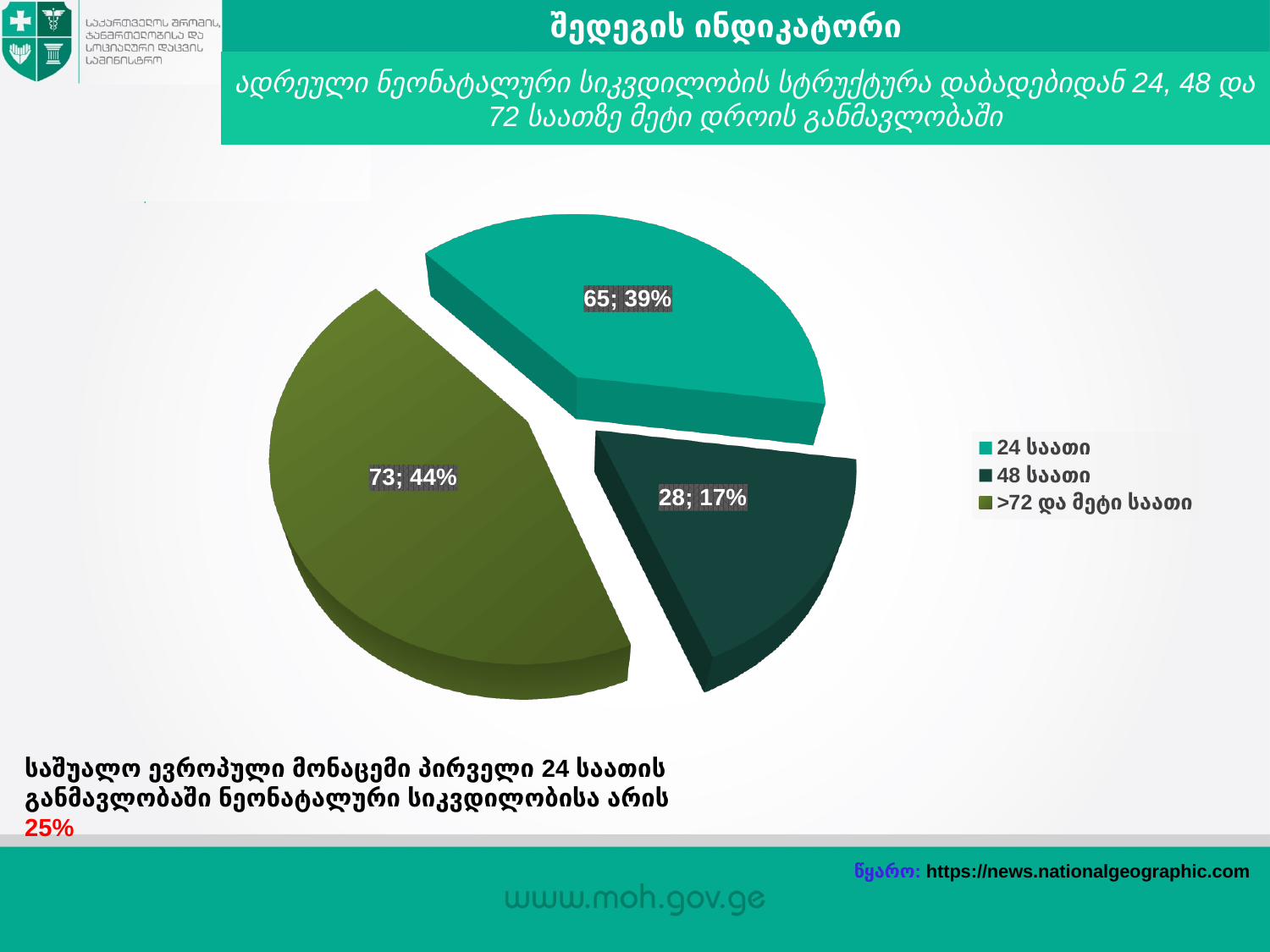
What kind of chart is shown on the slide? pie chart What percentage share does the ">72 და მეტი საათი" slice have? 44% What is the count shown for the ">72 და მეტი საათი" slice? 73 How many slices does the pie chart have? 3 What percentage share does the "48 საათი" slice have? 17% What percentage share does the "24 საათი" slice have? 39% What is the count shown for the "48 საათი" slice? 28 Which slice is the smallest? 48 საათი Which slice is the largest? >72 და მეტი საათი How many entries does the legend list? 3 What is the difference between the counts for ">72 და მეტი საათი" and "48 საათი"? 45 What is the count shown for the "24 საათი" slice? 65